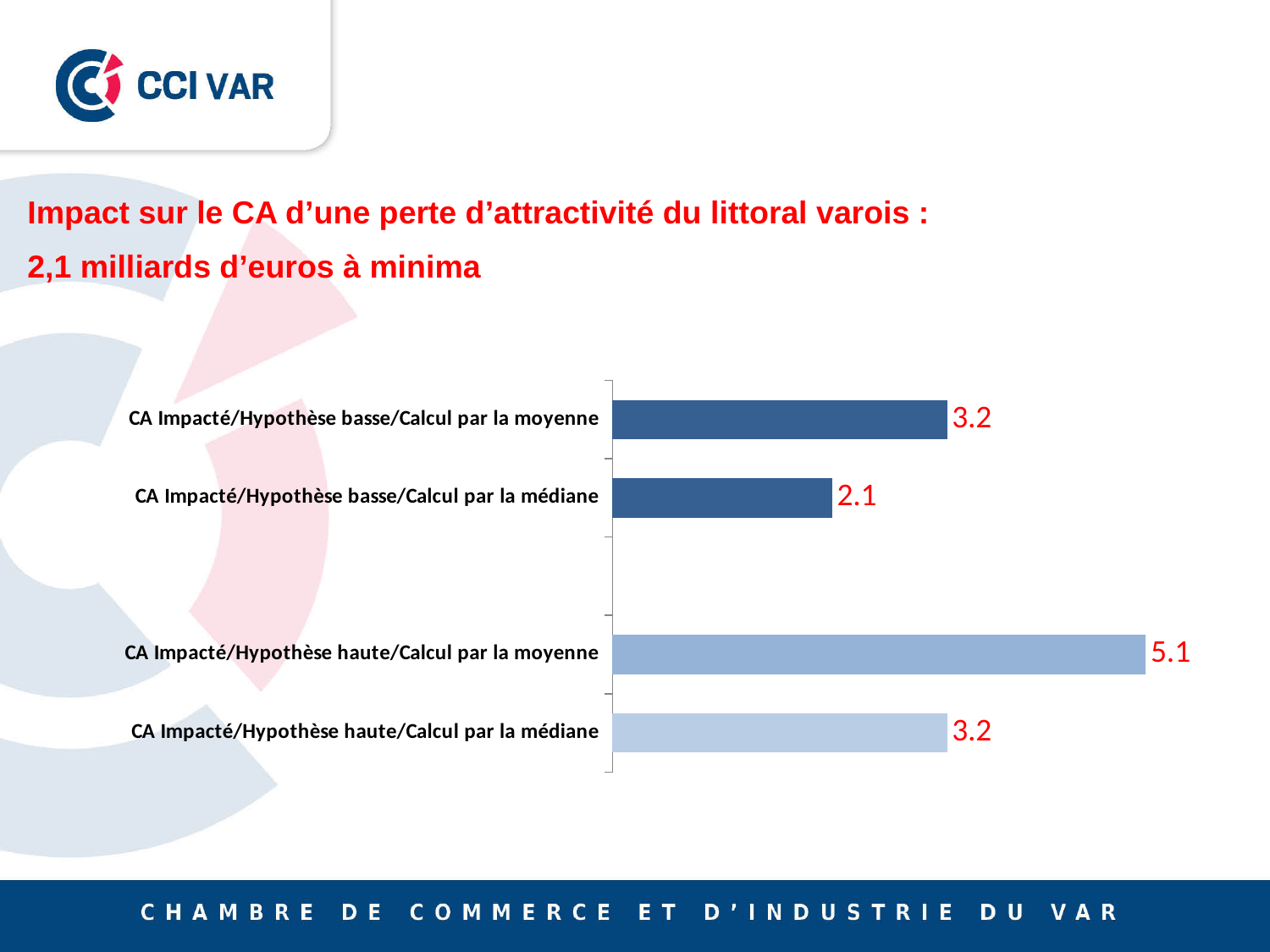
What kind of chart is shown on the slide? Bar chart What is the value for 'CA Impacté/Hypothèse basse/Calcul par la médiane'? 2.1 Which is larger: 'CA Impacté/Hypothèse basse/Calcul par la moyenne' or 'CA Impacté/Hypothèse basse/Calcul par la médiane'? CA Impacté/Hypothèse basse/Calcul par la moyenne How many bars are plotted in the chart? 4 What is the value for 'CA Impacté/Hypothèse basse/Calcul par la moyenne'? 3.2 What is the value for 'CA Impacté/Hypothèse haute/Calcul par la médiane'? 3.2 What is the title text above the chart? Impact sur le CA d'une perte d'attractivité du littoral varois : 2,1 milliards d'euros à minima Which category has the lowest value? CA Impacté/Hypothèse basse/Calcul par la médiane What is the difference between 'CA Impacté/Hypothèse haute/Calcul par la moyenne' and 'CA Impacté/Hypothèse haute/Calcul par la médiane'? 1.9 What is the value for 'CA Impacté/Hypothèse haute/Calcul par la moyenne'? 5.1 What is the difference between 'CA Impacté/Hypothèse haute/Calcul par la moyenne' and 'CA Impacté/Hypothèse basse/Calcul par la médiane'? 3.0 Which category has the highest value? CA Impacté/Hypothèse haute/Calcul par la moyenne